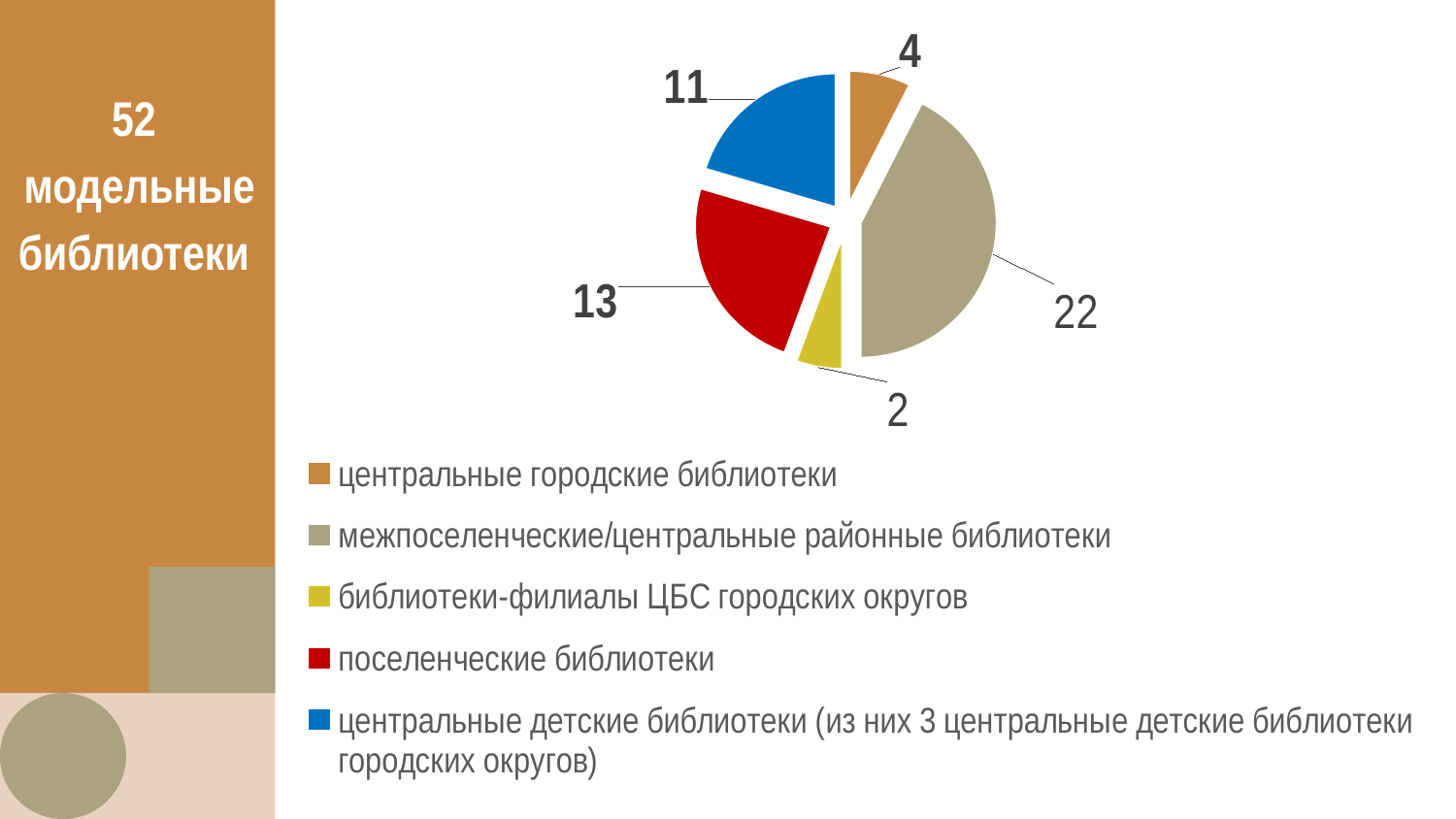
What is the value for центральные городские библиотеки? 4 What is the value for межпоселенческие/центральные районные библиотеки? 22 Which is larger: the value for поселенческие библиотеки or the value for центральные детские библиотеки? поселенческие библиотеки What share of the pie does the поселенческие библиотеки slice represent? 25% How many entries does the legend of the pie chart list? 5 Which category has the smallest slice of the pie? библиотеки-филиалы ЦБС городских округов What is the value for поселенческие библиотеки? 13 What is the value for центральные детские библиотеки? 11 Which category has the largest slice of the pie? межпоселенческие/центральные районные библиотеки How many slices does the pie chart have? 5 What is the difference between the values for межпоселенческие/центральные районные библиотеки and поселенческие библиотеки? 9 What type of chart is shown on the slide? pie chart